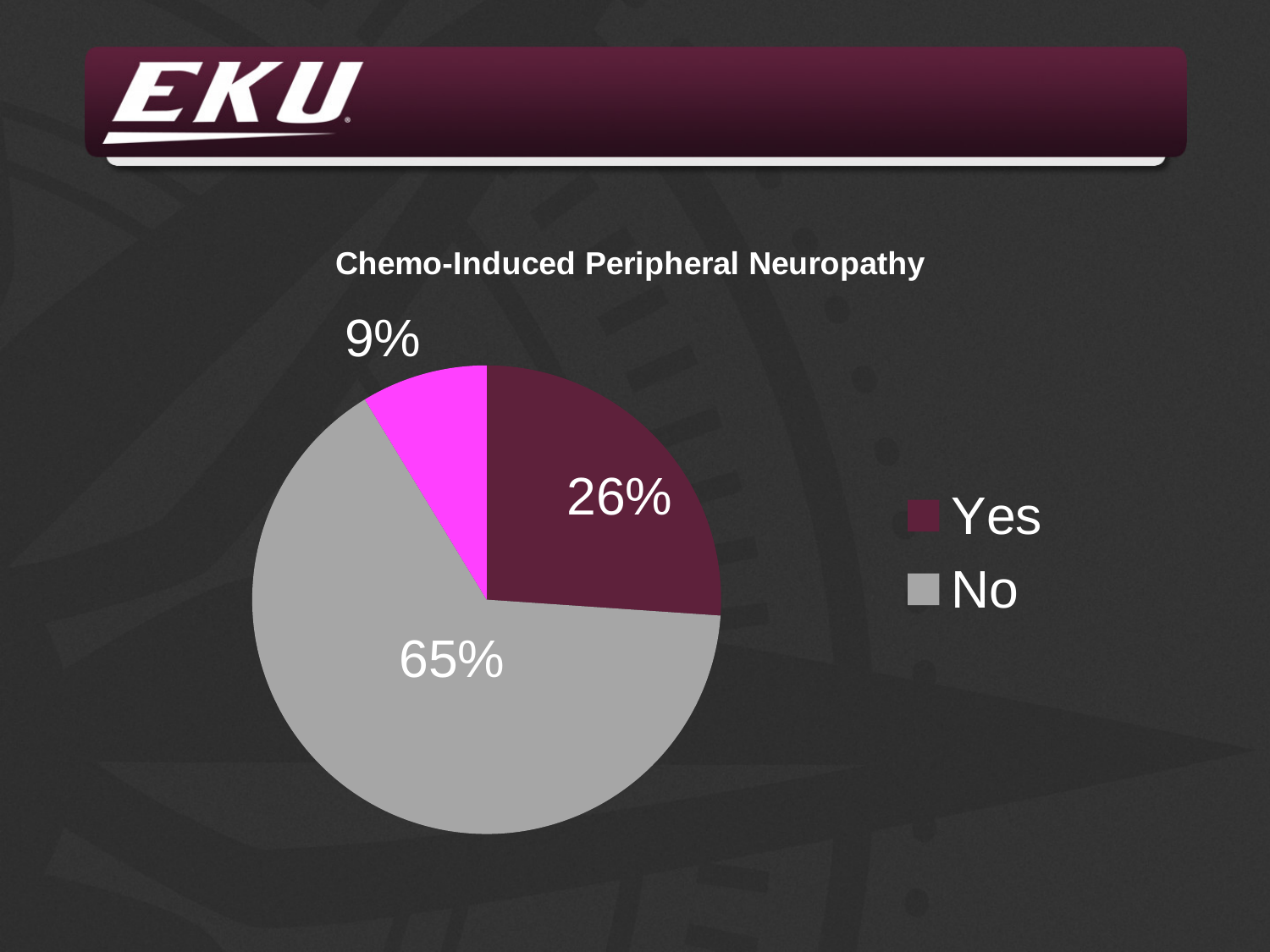
What share of the pie does the "Yes" slice represent? 26% Which is larger, the "Yes" slice or the "No" slice? No What is the smallest percentage label shown on the pie chart? 9% What colour is the "No" slice in the pie chart? gray What is the difference in percentage points between the "No" slice and the "Yes" slice? 39 How many slices does the pie chart have? 3 What share of the pie does the "No" slice represent? 65% What is the title of the pie chart? Chemo-Induced Peripheral Neuropathy Which slice is the largest in the pie chart? No How many entries does the legend list? 2 What kind of chart is shown on the slide? pie chart